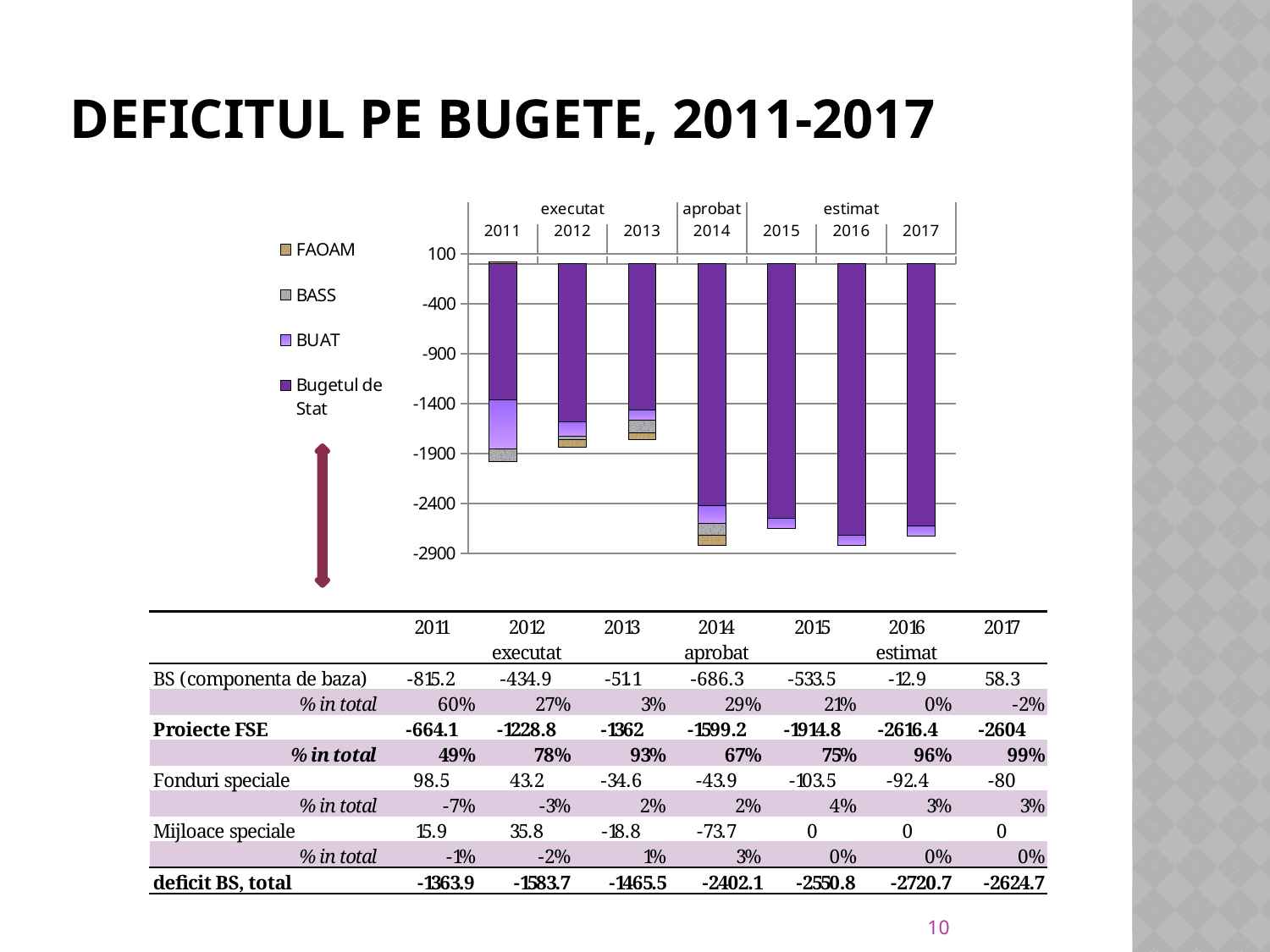
Is the Bugetul de Stat value for 2014 greater or less than -1900? less What kind of chart is shown on the slide? bar chart How many years are plotted along the x axis of the chart? 7 Is the Bugetul de Stat value for 2017 greater or less than -2400? less How many series does the chart legend list? 4 Which years on the chart's x axis are grouped under the label 'estimat'? 2015, 2016, 2017 Is the Bugetul de Stat value for 2013 greater or less than -1900? greater According to the 'deficit BS, total' row of the table, what is the value for 2014? -2402.1 Which year has the larger Bugetul de Stat deficit segment, 2011 or 2014? 2014 According to the 'deficit BS, total' row of the table, which year has the largest deficit? 2016 Does the Bugetul de Stat deficit segment grow or shrink from 2013 to 2016? grow Which series are listed in the chart legend? FAOAM, BASS, BUAT, Bugetul de Stat